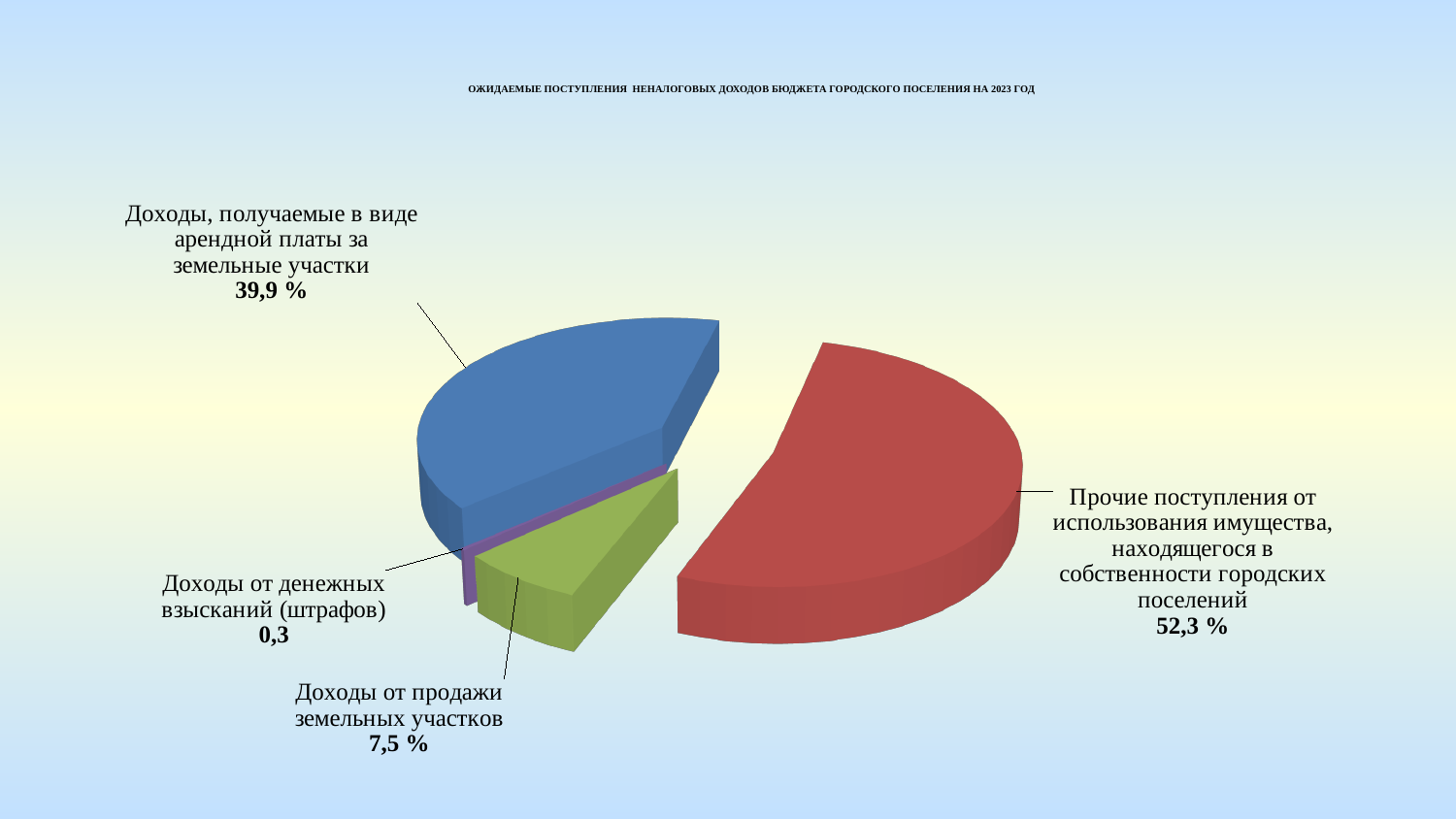
What value is shown for "Доходы от продажи земельных участков"? 7,5 % How many slices does the pie chart have? 4 What value is shown for "Доходы, получаемые в виде арендной платы за земельные участки"? 39,9 % Which category has the smallest slice of the pie? Доходы от денежных взысканий (штрафов) What kind of chart is shown on the slide? Pie chart What value is shown for "Доходы от денежных взысканий (штрафов)"? 0,3 What is the difference between the share for "Прочие поступления от использования имущества" and the share for "Доходы, получаемые в виде арендной платы за земельные участки"? 12,4 % What is the title of the chart? ОЖИДАЕМЫЕ ПОСТУПЛЕНИЯ НЕНАЛОГОВЫХ ДОХОДОВ БЮДЖЕТА ГОРОДСКОГО ПОСЕЛЕНИЯ НА 2023 ГОД Which category has the largest slice of the pie? Прочие поступления от использования имущества, находящегося в собственности городских поселений What colour is the slice for "Доходы от продажи земельных участков"? Green Which is larger: the share for "Доходы от продажи земельных участков" or the share for "Доходы, получаемые в виде арендной платы за земельные участки"? Доходы, получаемые в виде арендной платы за земельные участки What share of the pie is labelled for "Прочие поступления от использования имущества, находящегося в собственности городских поселений"? 52,3 %